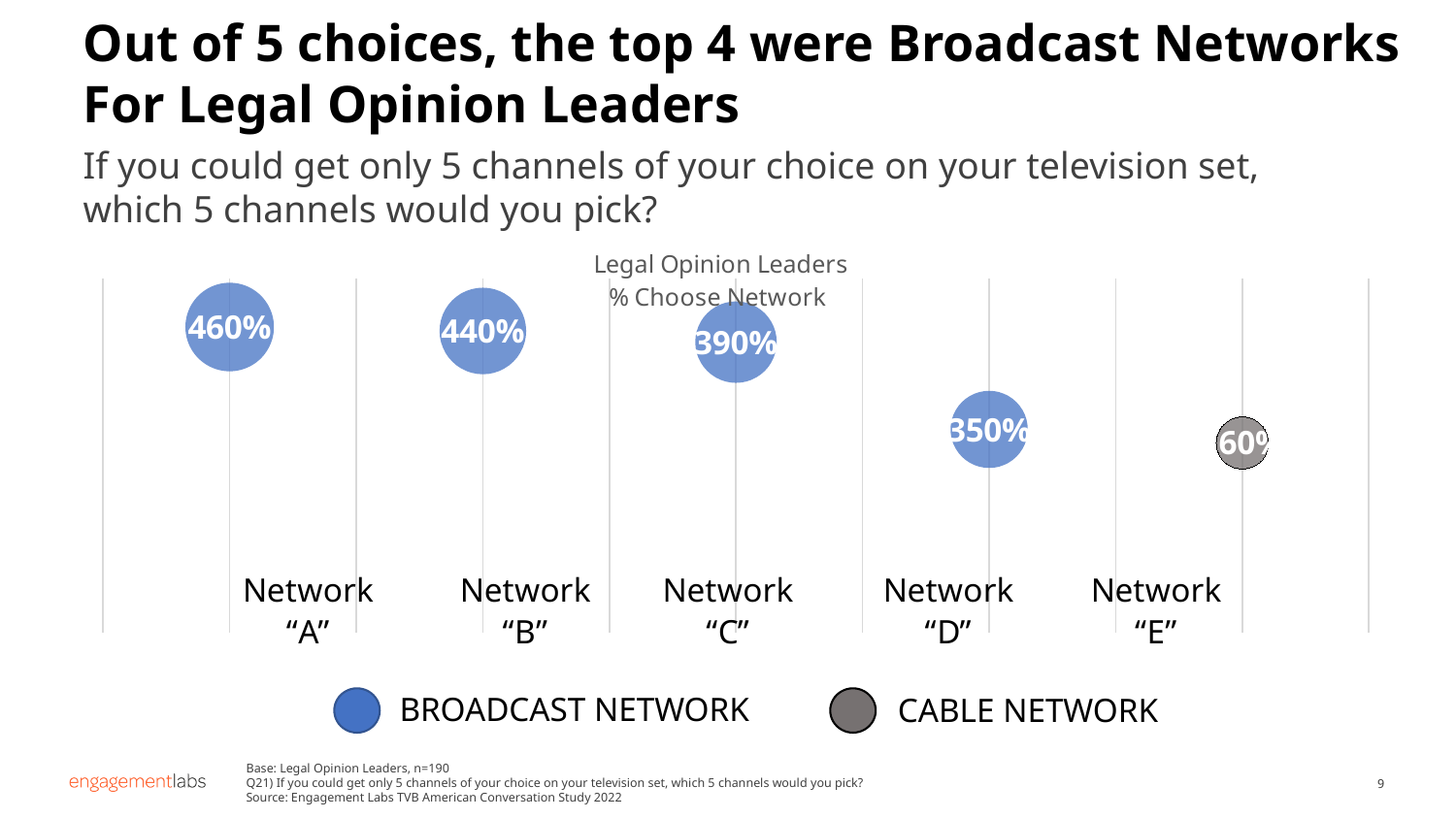
Which network has the highest value? Network "A" What is the difference between the values for Network "A" and Network "B"? 20% Which network has the lowest value? Network "E" What is the value for Network "B"? 440% Which network is shown as a Cable Network in the legend colour? Network "E" Which is larger, the value for Network "B" or Network "D"? Network "B" What is the value for Network "C"? 390% How many networks are plotted on the chart? 5 What is the value for Network "A"? 460% What is the value for Network "D"? 350% Do the values rise or fall from Network "A" to Network "E"? fall What is the difference between the values for Network "C" and Network "D"? 40%